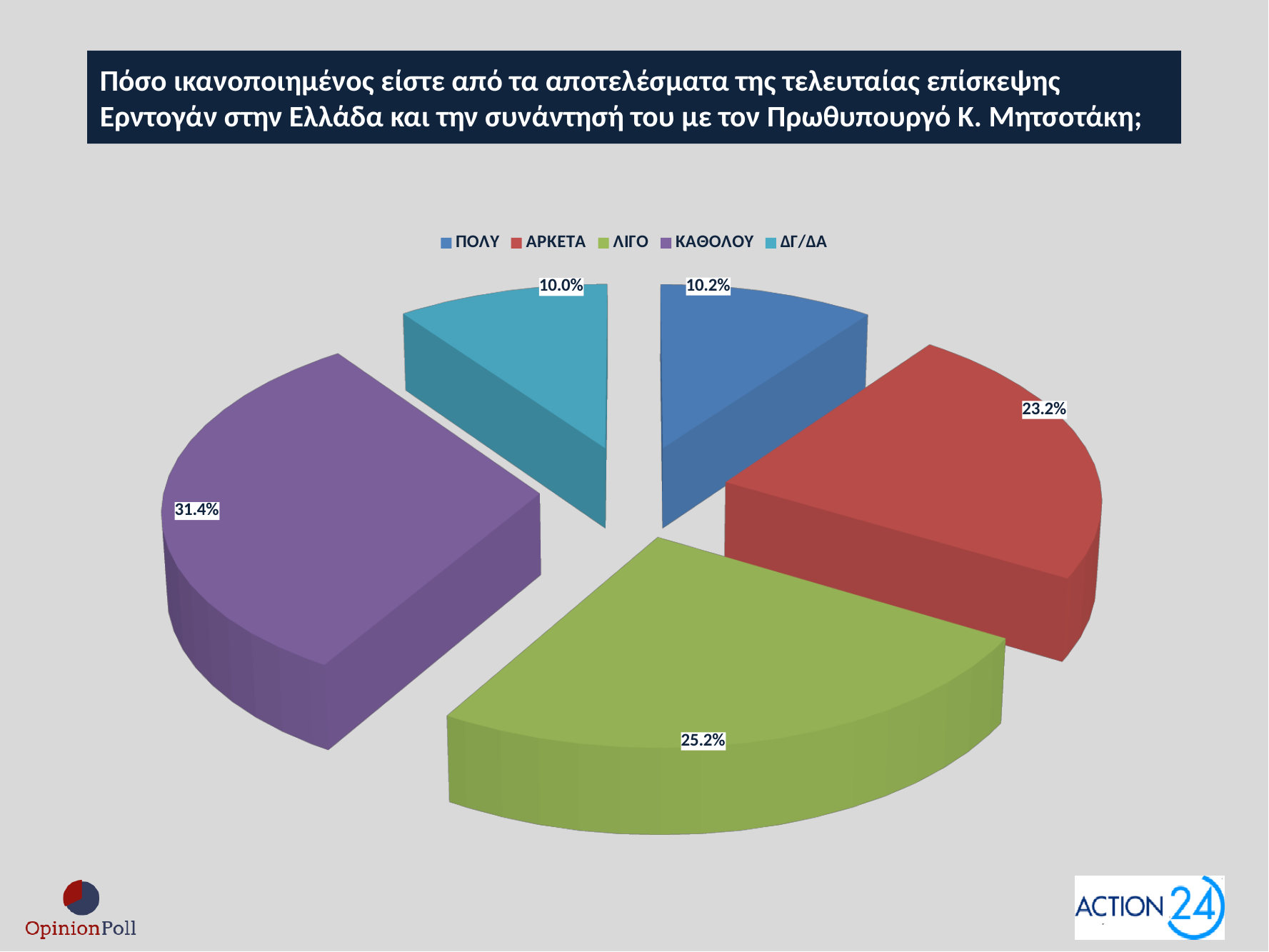
What is the difference in percentage points between ΚΑΘΟΛΟΥ and ΑΡΚΕΤΑ? 8.2 What kind of chart is shown on the slide? Pie chart What percentage of respondents answered ΛΙΓΟ? 25.2% What percentage of respondents answered ΚΑΘΟΛΟΥ? 31.4% Which response category has the smallest share of the pie? ΔΓ/ΔΑ What percentage of respondents answered ΠΟΛΥ? 10.2% How many categories are shown in the pie chart? 5 What percentage of respondents answered ΔΓ/ΔΑ? 10.0% Which is larger, the share for ΛΙΓΟ or the share for ΑΡΚΕΤΑ? ΛΙΓΟ Which response category has the largest share of the pie? ΚΑΘΟΛΟΥ What colour is the slice for ΚΑΘΟΛΟΥ? Purple What percentage of respondents answered ΑΡΚΕΤΑ? 23.2%